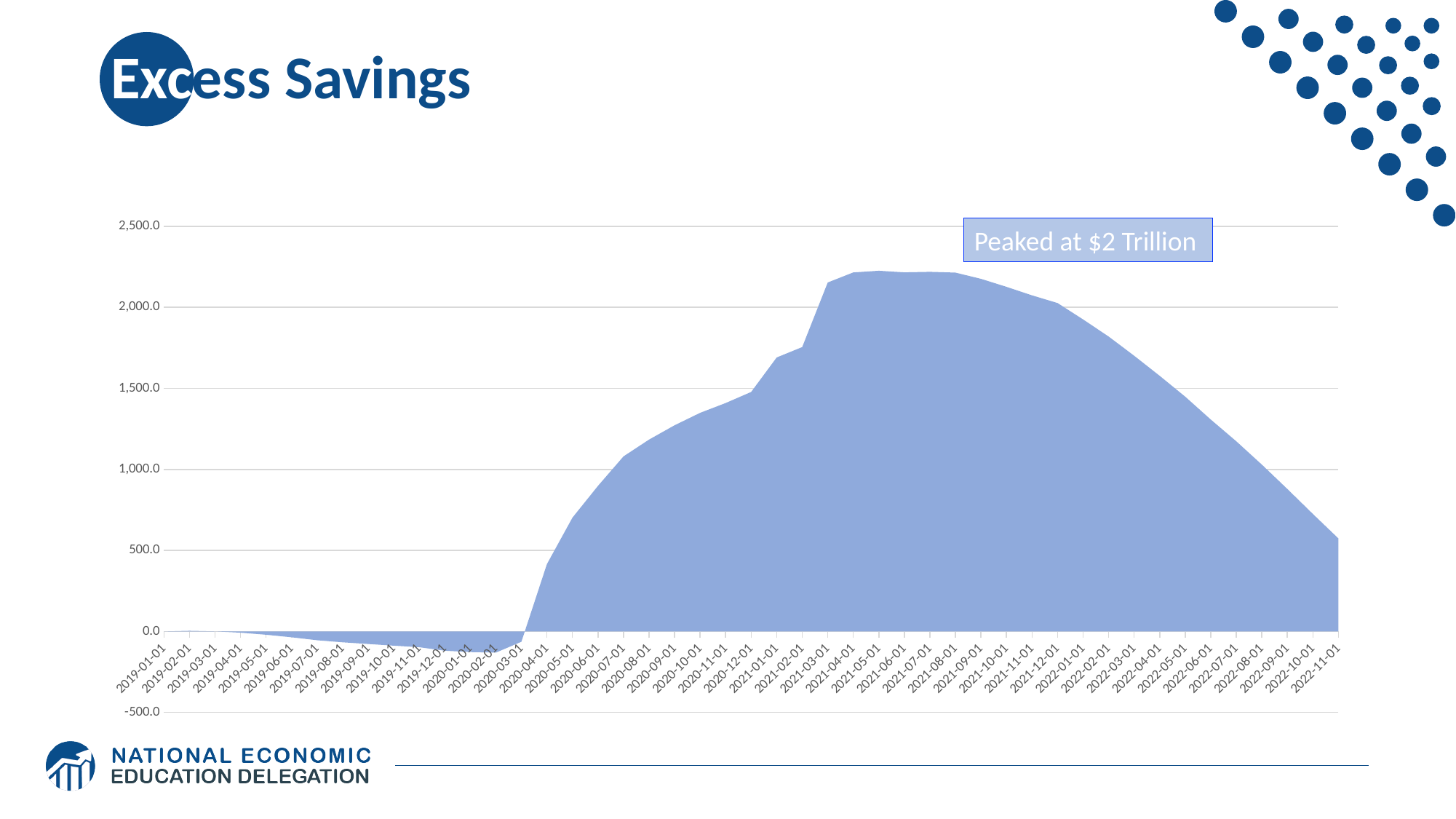
What does the annotation box on the chart say? Peaked at $2 Trillion Do the values rise or fall between 2020-03-01 and 2021-06-01? rise Is the value for 2020-07-01 greater or less than 1,000? greater Is the value for 2022-11-01 greater or less than 500? greater Is the value for 2021-06-01 greater or less than 2,000? greater What kind of chart is shown on the slide? area chart What is the title of the slide containing the chart? Excess Savings Do the values rise or fall between 2021-08-01 and 2022-11-01? fall How many monthly dates are shown on the x axis? 47